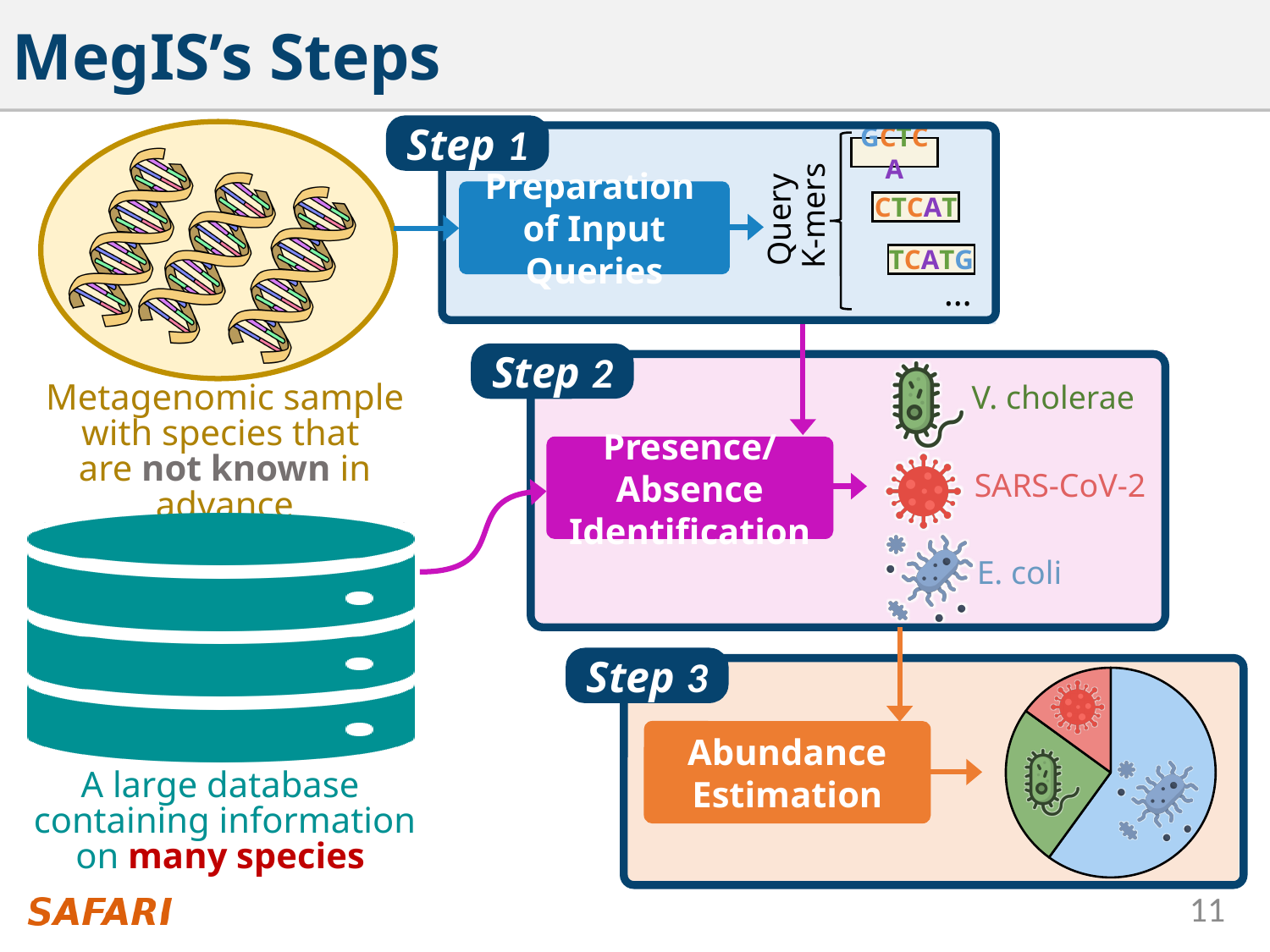
What kind of chart is shown in the Step 3 box on the slide? pie chart In the pie chart in the Step 3 box, which colour slice is the smallest? red How many slices does the pie chart in the Step 3 box have? 3 In the pie chart in the Step 3 box, which colour slice is the largest? blue In the pie chart in the Step 3 box, is the blue slice larger or smaller than the green slice? larger